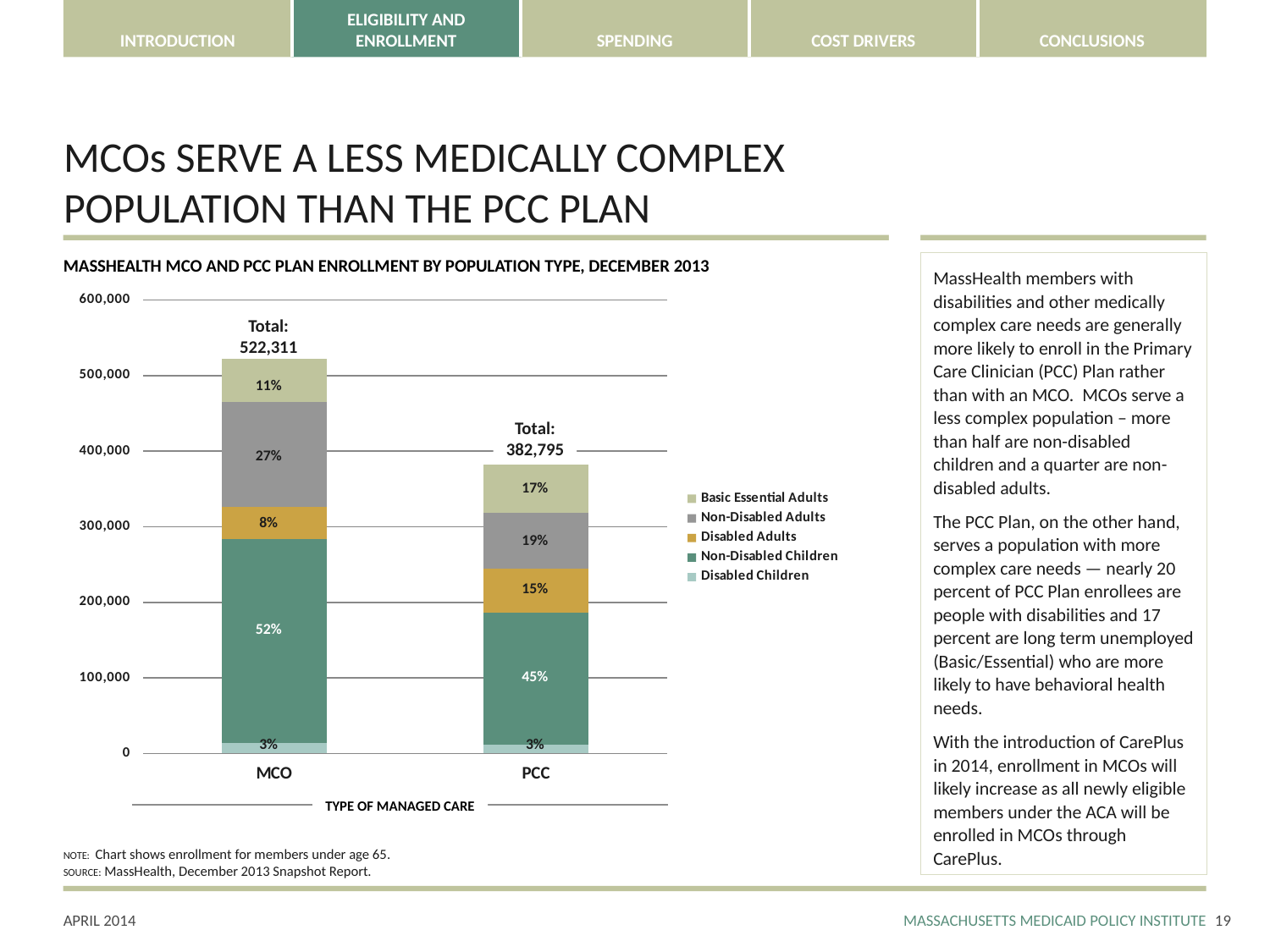
What percentage of PCC enrollment is Non-Disabled Adults? 19% How many population types does the legend list? 5 Is the total enrollment for PCC greater or less than 400,000? less What kind of chart is shown on the slide? Stacked bar chart How many types of managed care are shown on the x axis? 2 What percentage of PCC enrollment is Basic Essential Adults? 17% What is the difference between the MCO total and the PCC total? 139,516 What percentage of MCO enrollment is Disabled Adults? 8% What percentage of MCO enrollment is Non-Disabled Children? 52% What is the total enrollment shown for the MCO bar? 522,311 Which type of managed care has the larger total enrollment, MCO or PCC? MCO What is the total enrollment shown for the PCC bar? 382,795